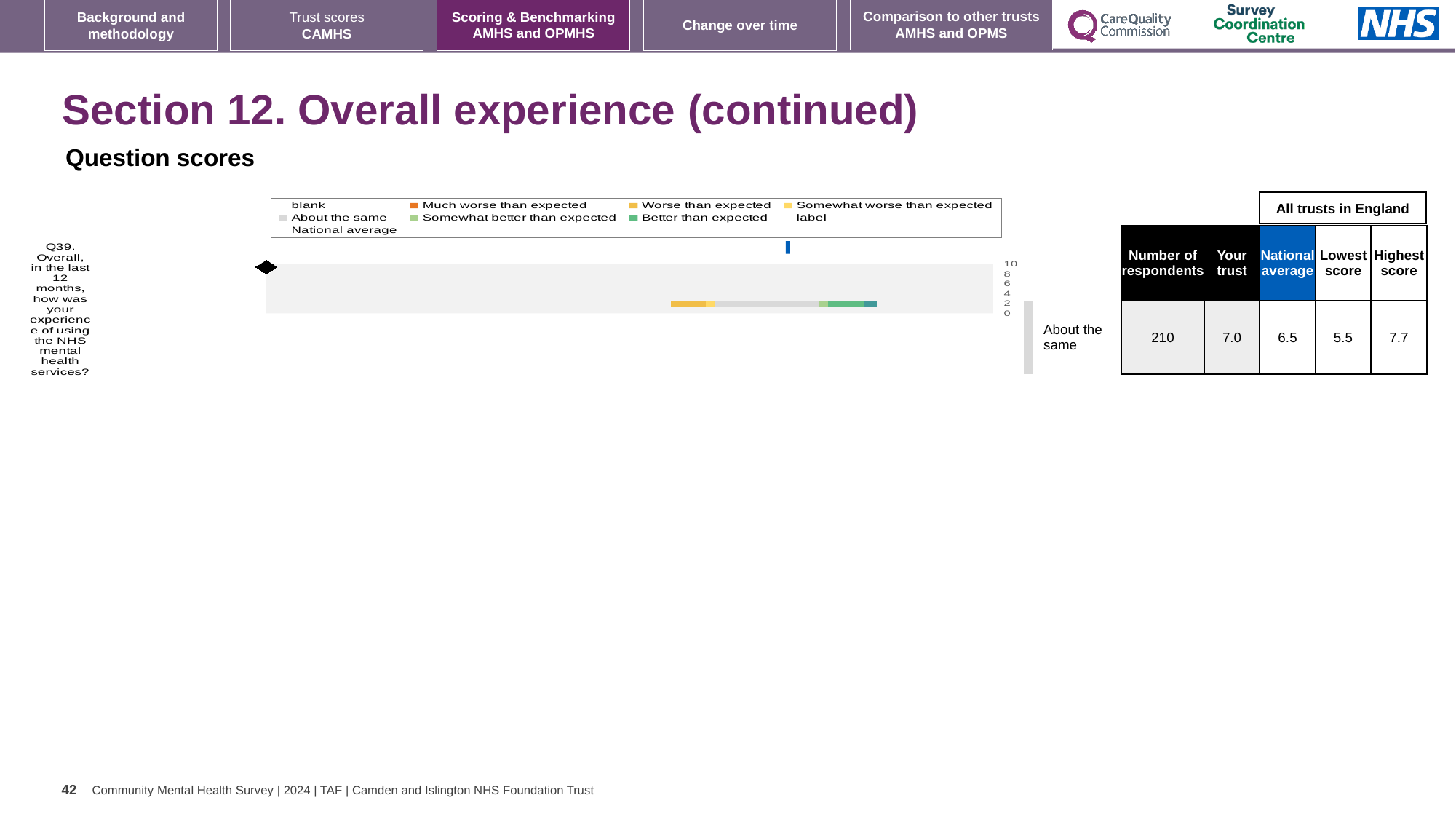
In the table beside the chart, how many respondents answered Q39? 210 What is the difference between the highest score and the lowest score for Q39 in the table? 2.2 In the table beside the chart, what is the 'Your trust' score for Q39? 7.0 What kind of chart is shown on the slide? bar chart In the table beside the chart, what is the national average score for Q39? 6.5 Is the 'Your trust' score for Q39 greater or less than 6? greater How many survey questions are plotted in the chart? 1 Which is larger for Q39, the 'Your trust' score or the national average? Your trust In the table beside the chart, what is the highest score among all trusts in England for Q39? 7.7 What benchmark category is shown for Q39 to the right of the chart? About the same Which survey question is plotted in the chart? Q39. Overall, in the last 12 months, how was your experience of using the NHS mental health services? What is the highest value shown on the chart's score axis? 10